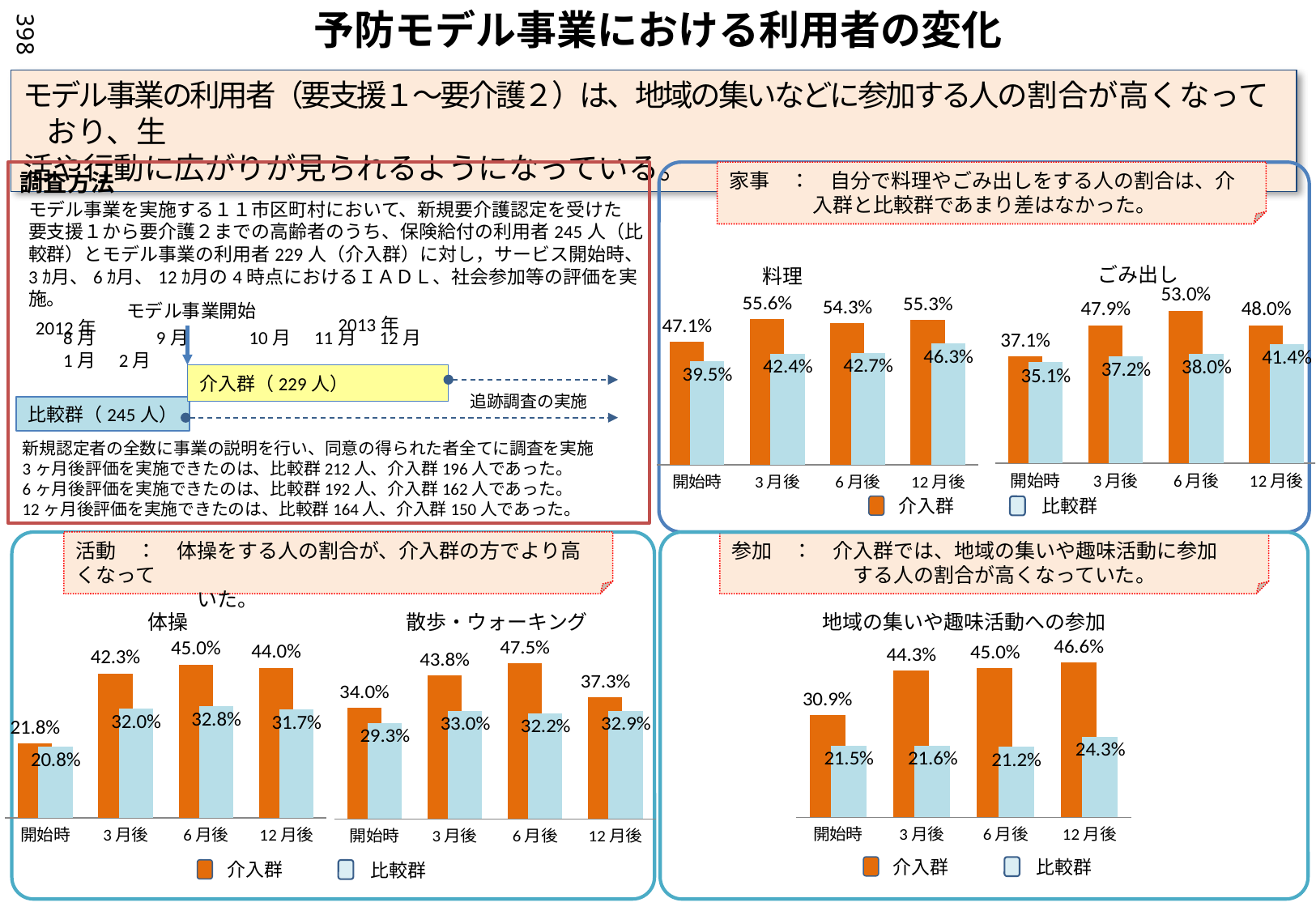
In the 地域の集いや趣味活動への参加 chart, what is the difference between 介入群 and 比較群 at 12月後? 22.3% How many series does the legend of the 地域の集いや趣味活動への参加 chart list? 2 In the ごみ出し chart, which is larger at 6月後: 介入群 or 比較群? 介入群 Which colour represents 介入群 in the charts? Orange What kind of chart is the 料理 chart? Bar chart In the ごみ出し chart, what is the value for 比較群 at 12月後? 41.4% In the 散歩・ウォーキング chart, at which time point is the 比較群 value lowest? 開始時 In the 地域の集いや趣味活動への参加 chart, does the 介入群 value rise or fall from 開始時 to 12月後? Rise In the 料理 chart, what is the value for 介入群 at 3月後? 55.6% In the 体操 chart, how many time points are shown on the x axis? 4 In the 体操 chart, at which time point is the 介入群 value highest? 6月後 In the 散歩・ウォーキング chart, what is the value for 介入群 at 6月後? 47.5%